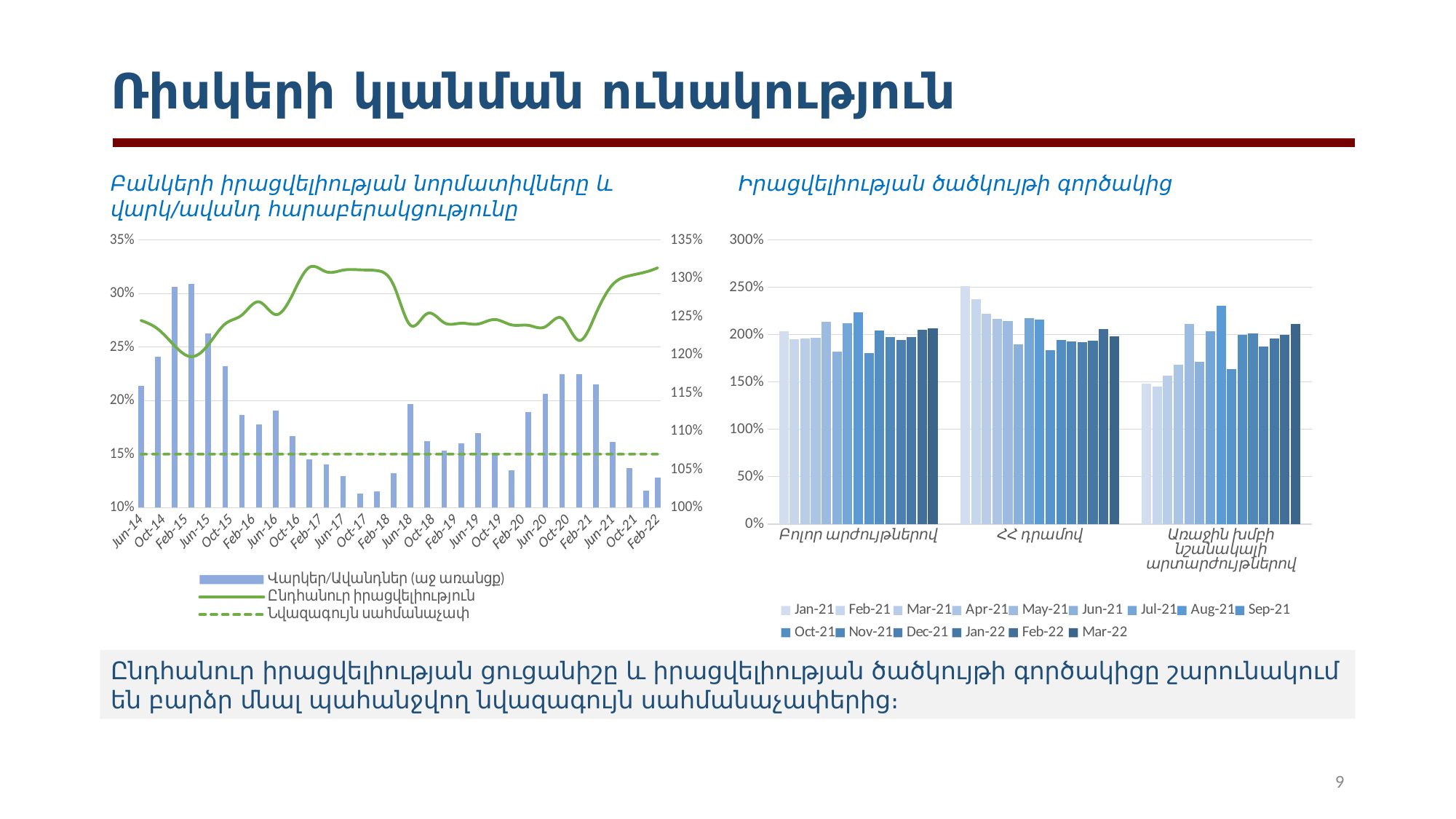
In the left-hand chart, do the bars rise or fall between Jun-15 and Oct-17? fall What kind of chart is the right-hand chart titled "Իրացվելիության ծածկույթի գործակից"? Bar chart In the right-hand chart, which series has the highest bar in the "Առաջին խմբի նշանակալի արտարժույթներով" group? Aug-21 In the right-hand chart, is the Jan-21 bar larger for "Բոլոր արժույթներով" or for "Առաջին խմբի նշանակալի արտարժույթներով"? Բոլոր արժույթներով In the right-hand chart, is the Jan-21 value for "Առաջին խմբի նշանակալի արտարժույթներով" greater or less than 200%? less In the right-hand chart, which series has the highest bar in the "ՀՀ դրամով" group? Jan-21 How many entries does the legend of the left-hand chart list? 3 In the right-hand chart, is the Jan-21 value for "ՀՀ դրամով" greater or less than 200%? greater How many category groups are shown on the x axis of the right-hand chart? 3 In the left-hand chart, is the bar for Feb-15 greater or less than 25%? greater How many series does the legend of the right-hand chart list? 15